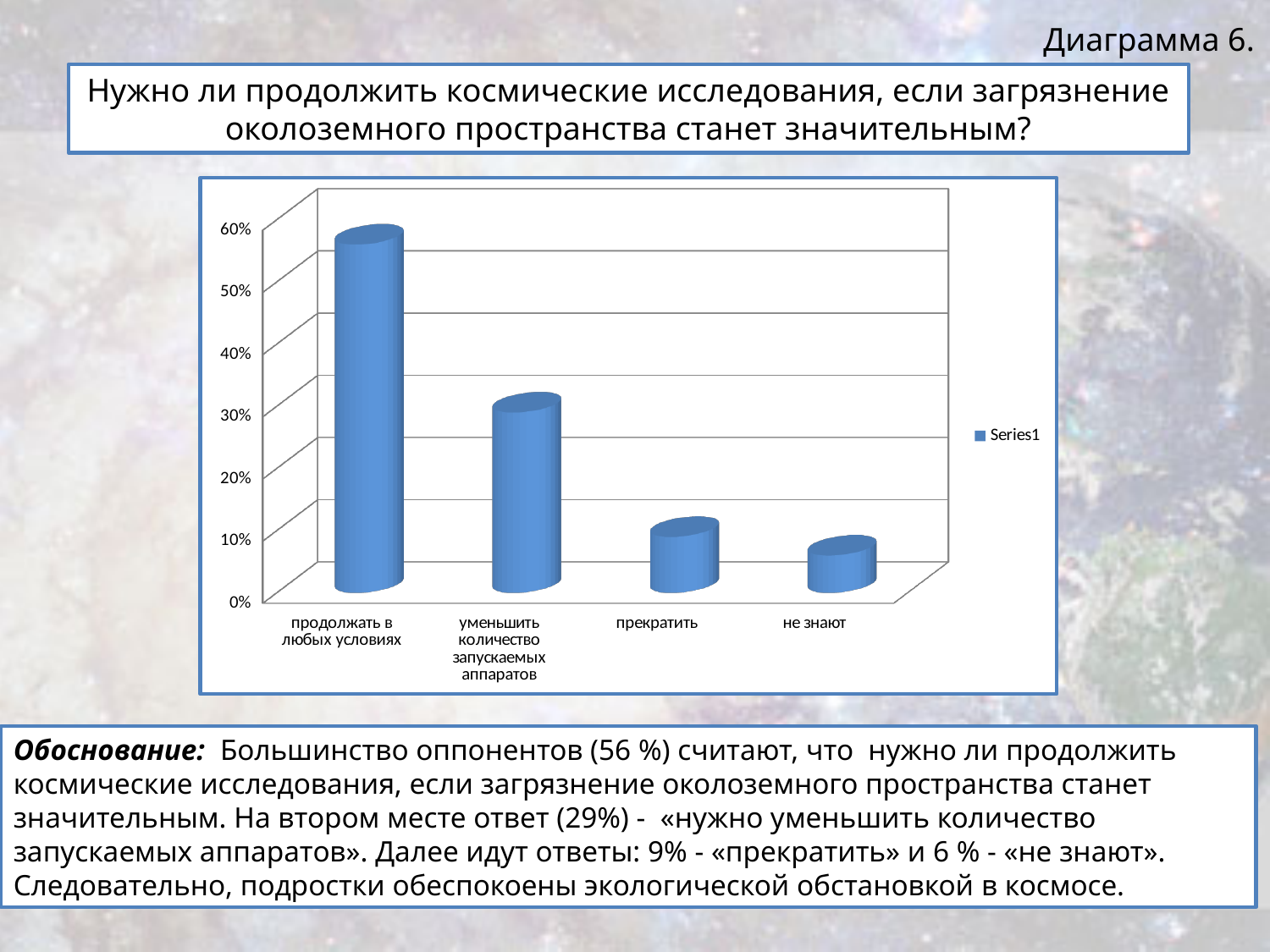
Which category has the highest bar in the chart? продолжать в любых условиях How many categories are shown on the x axis of the chart? 4 Is the value for «продолжать в любых условиях» greater or less than 50%? greater What kind of chart is shown on the slide? bar chart What is the name of the series shown in the chart legend? Series1 Is the value for «прекратить» greater or less than 20%? less Do the bar values rise or fall from left to right along the x axis? fall Is the value for «не знают» greater or less than 10%? less Which category has the lowest bar in the chart? не знают How many series does the chart legend list? 1 Which is larger, the value for «прекратить» or the value for «не знают»? прекратить